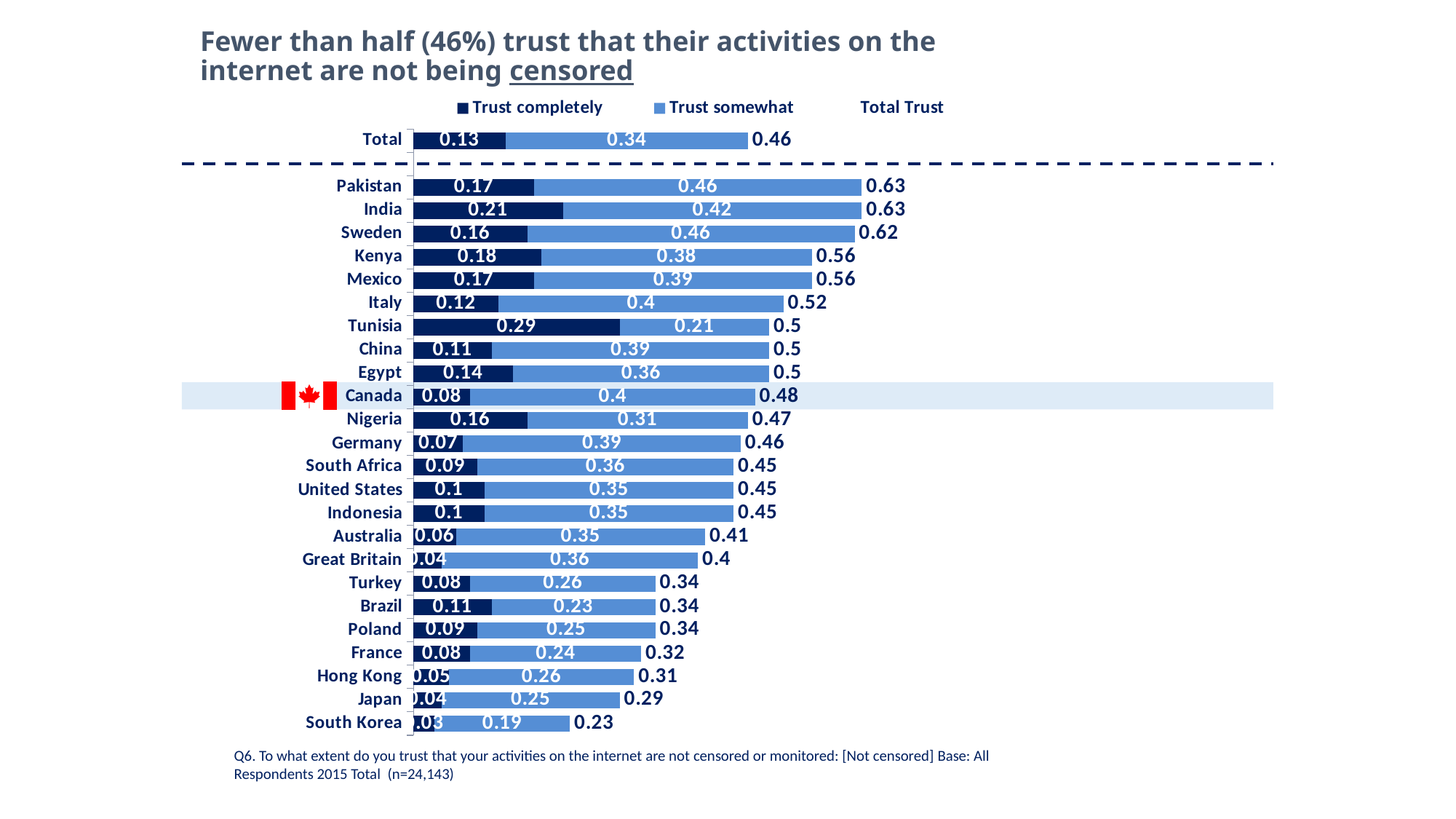
Which has a larger Total Trust value, Kenya or Italy? Kenya Which country's row is highlighted with a flag on the chart? Canada What kind of chart is shown on the slide? Stacked bar chart Which country has the highest 'Trust completely' value? Tunisia What is the difference between the Total Trust values for Pakistan and Canada? 0.15 What is the Total Trust value for Japan? 0.29 What is the 'Trust somewhat' value for Sweden? 0.46 What is the 'Trust completely' value for Tunisia? 0.29 Which country has the lowest Total Trust value? South Korea What is the total of the stacked bar for Egypt? 0.5 How many countries are listed below the dashed line? 24 What is the Total Trust value for Canada? 0.48